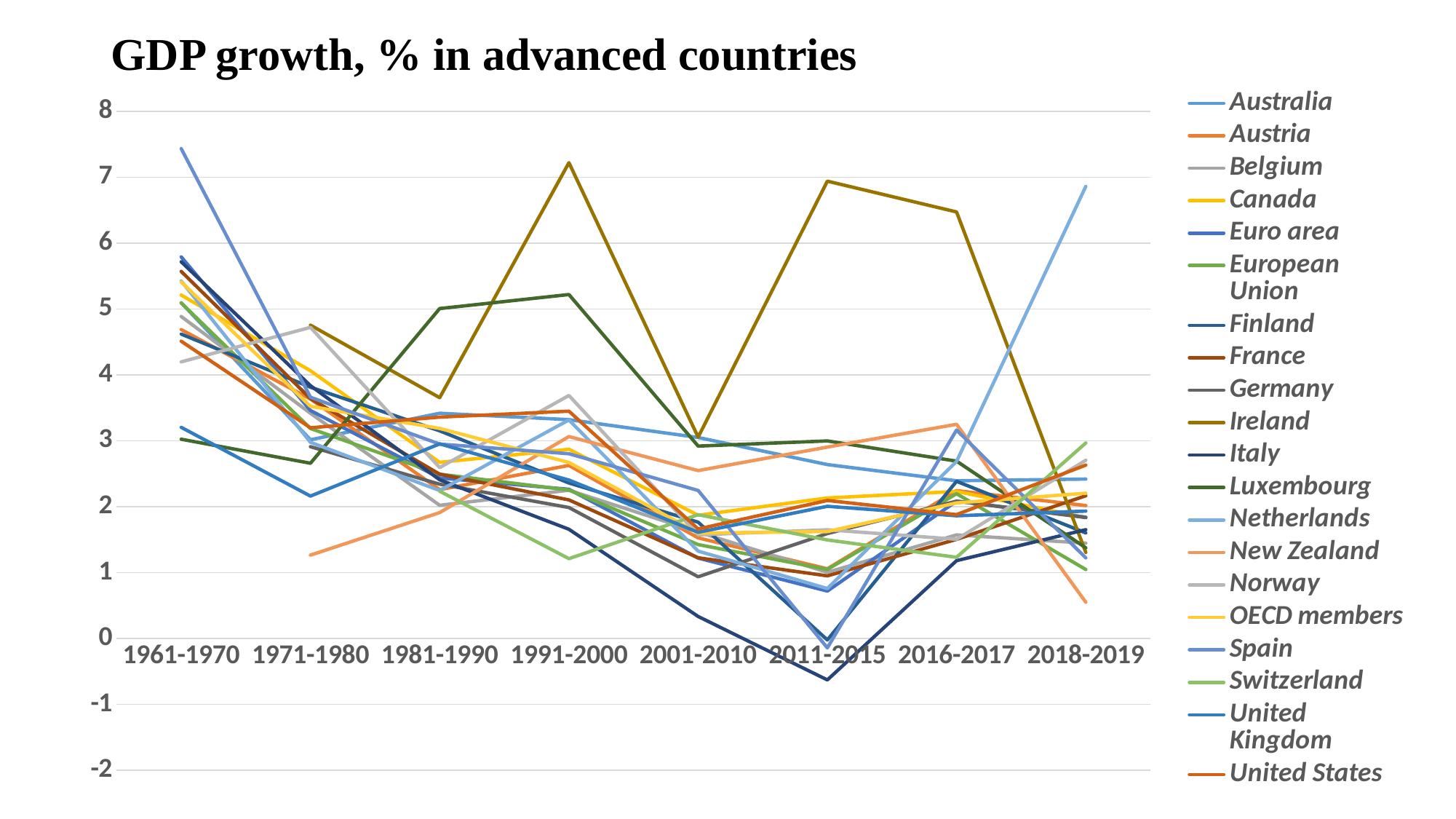
What kind of chart is shown on the slide? line chart What is the title of the chart? GDP growth, % in advanced countries Is the value for Italy in 2011-2015 greater or less than 0? less Which series has the lowest value in 2011-2015? Italy How many series does the legend list? 20 Is the value for Luxembourg in 1991-2000 greater or less than 5? greater Is the value for Ireland in 2011-2015 greater or less than 6? greater How many time periods are shown on the x axis? 8 Which series has the highest value in 1991-2000? Ireland